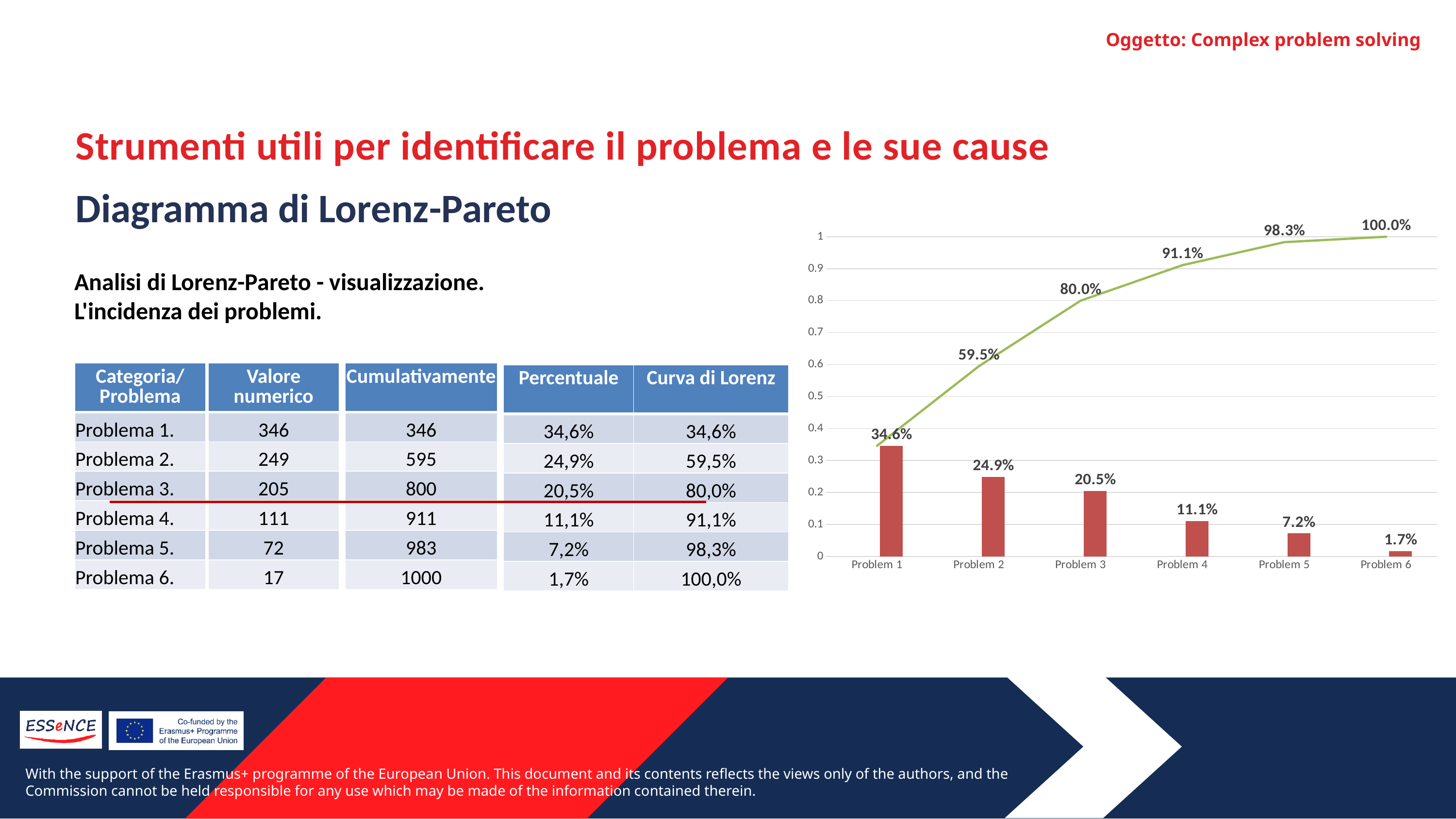
Do the bar values rise or fall from Problem 1 to Problem 6? fall How many problem categories are shown on the x axis? 6 What is the difference between the bar values for Problem 1 and Problem 2? 9.7% What is the bar value for Problem 3? 20.5% What is the cumulative line value at Problem 4? 91.1% What kind of chart is shown on the slide? Bar chart with a cumulative line What is the cumulative line value at Problem 3? 80.0% Which problem has the lowest bar? Problem 6 Which problem has the highest bar? Problem 1 Is the bar for Problem 2 greater or less than 0.2 on the axis? greater What is the bar value for Problem 6? 1.7% Which is larger, the bar for Problem 4 or the bar for Problem 5? Problem 4